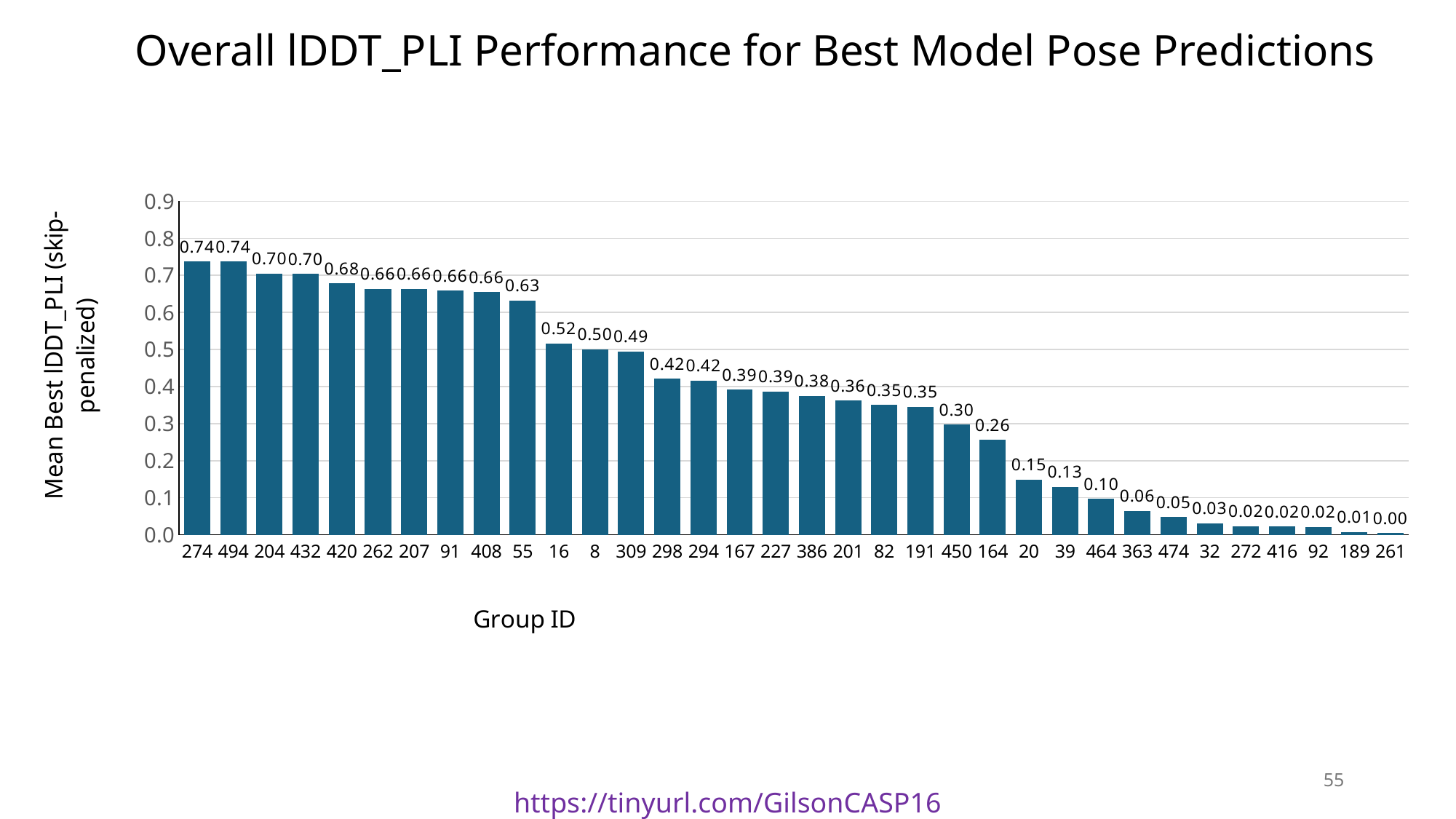
What is the difference between the values for group 274 and group 164? 0.48 What is the label of the x axis? Group ID What type of chart is shown on the slide? bar chart How many group IDs are shown on the x axis? 34 Which group has a higher mean best lDDT_PLI value, group 8 or group 298? 8 Which group ID has the lowest mean best lDDT_PLI value? 261 Do the values rise or fall moving from left to right along the x axis? fall What is the mean best lDDT_PLI value for group 39? 0.13 What is the mean best lDDT_PLI value for group 450? 0.30 What is the mean best lDDT_PLI value for group 16? 0.52 What is the difference between the values for group 55 and group 16? 0.11 What is the mean best lDDT_PLI value for group 420? 0.68